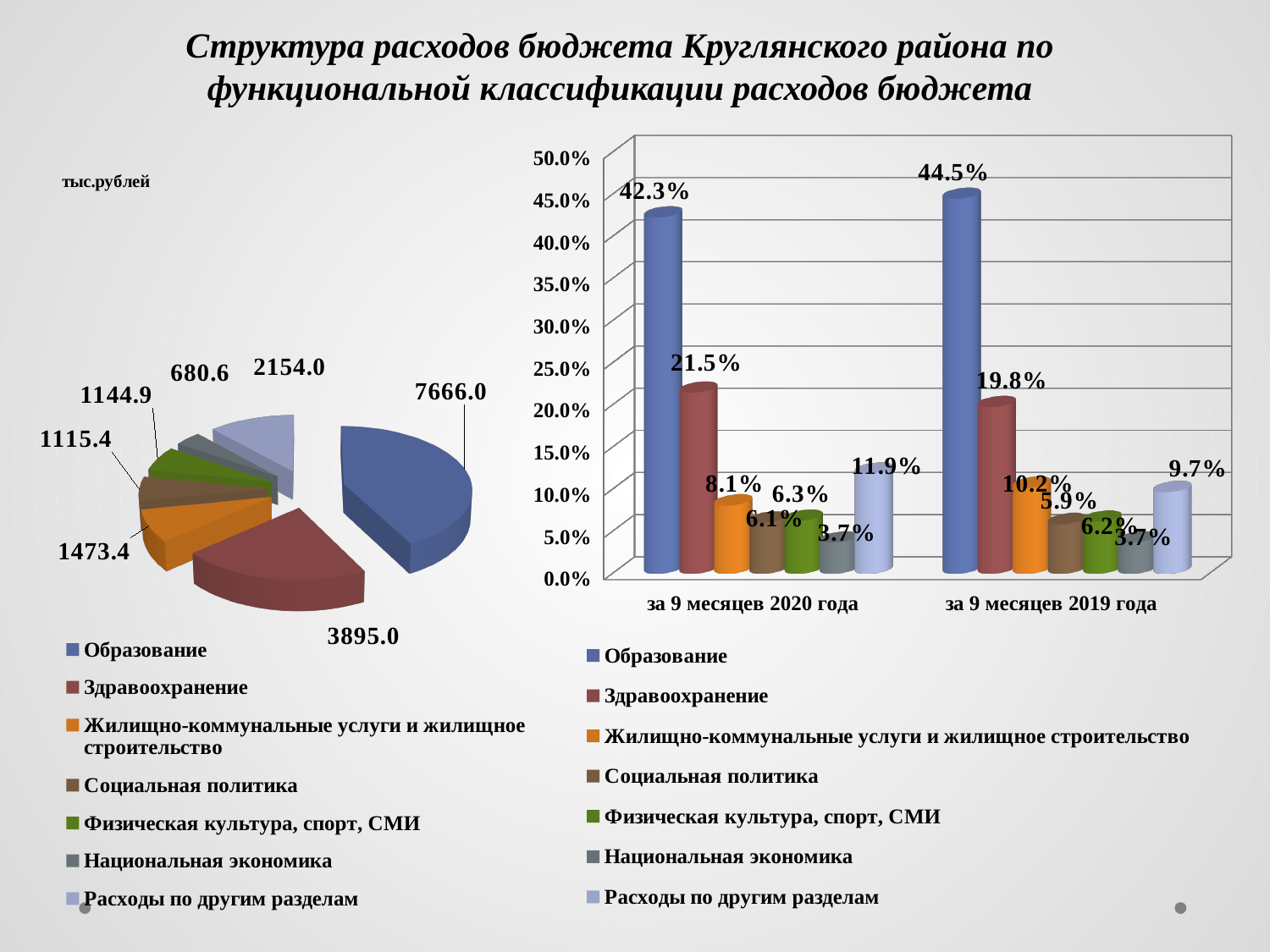
In the pie chart on the left, what is the value for Здравоохранение? 3895.0 In the bar chart on the right, what is the value for Образование for за 9 месяцев 2020 года? 42.3% In the pie chart on the left, what is the value for Образование? 7666.0 What kind of chart is the chart on the left of the slide? Pie chart In the bar chart on the right, what is the value for Расходы по другим разделам for за 9 месяцев 2020 года? 11.9% How many series does the legend of the bar chart on the right list? 7 In the bar chart on the right, is the value for Жилищно-коммунальные услуги и жилищное строительство larger for за 9 месяцев 2020 года or за 9 месяцев 2019 года? за 9 месяцев 2019 года In the bar chart on the right, which category has the highest value for за 9 месяцев 2019 года? Образование In the bar chart on the right, what is the difference between the Образование values for за 9 месяцев 2019 года and за 9 месяцев 2020 года? 2.2% In the pie chart on the left, which category has the smallest slice? Национальная экономика In the bar chart on the right, what is the value for Здравоохранение for за 9 месяцев 2019 года? 19.8% In the bar chart on the right, which category has the lowest value for за 9 месяцев 2020 года? Национальная экономика